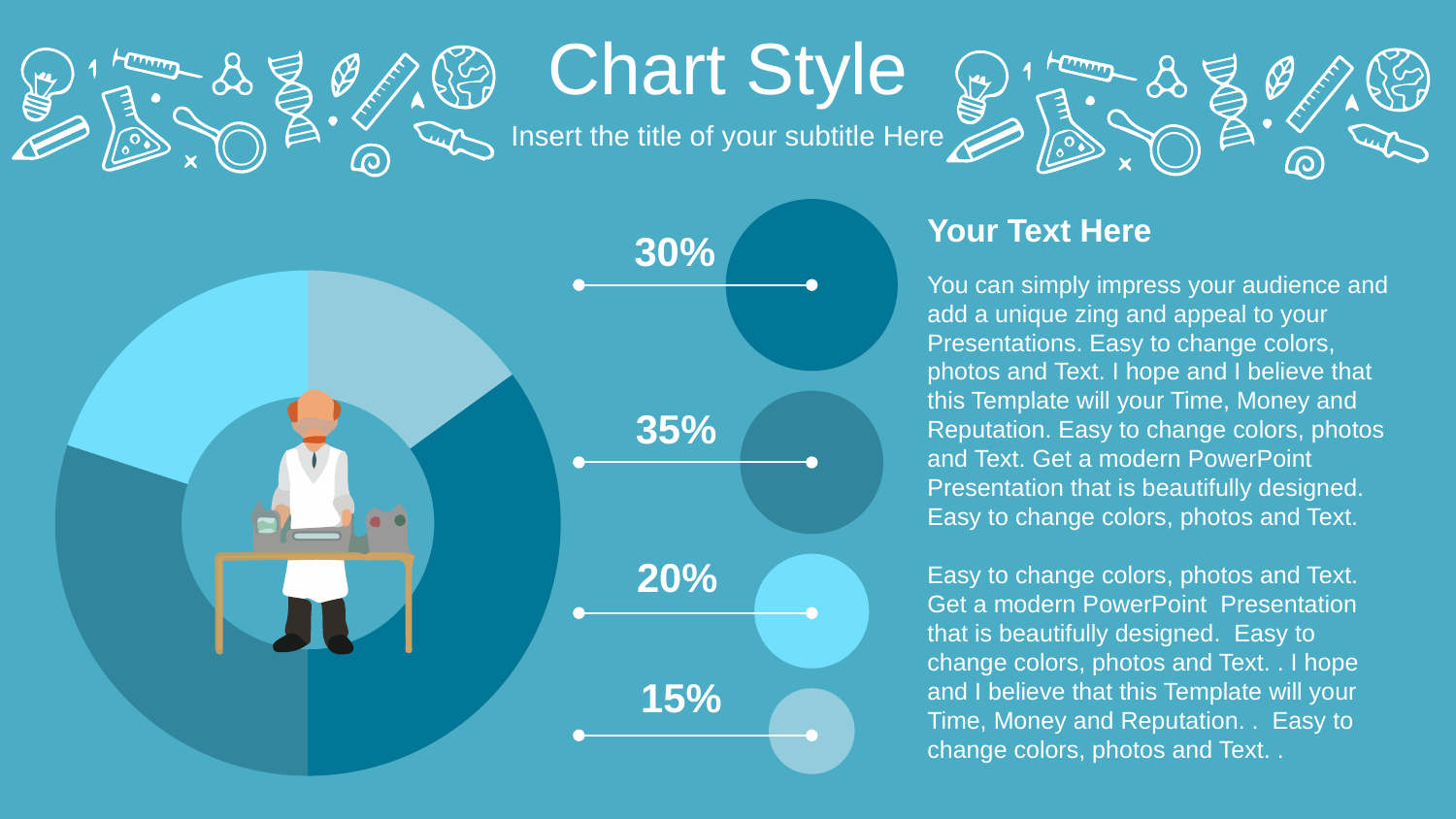
What percentage is listed third from the top next to the chart? 20% What is the subtitle text under the slide title? Insert the title of your subtitle Here What do the four percentages listed next to the chart add up to? 100% What is the largest percentage shown on the slide? 35% What is the smallest percentage shown on the slide? 15% What is the title of the slide? Chart Style What is the difference between the 35% value and the 30% value? 5% What percentage is listed at the top of the list next to the chart? 30% Which is larger, the third value (20%) or the fourth value (15%) in the list? 20% What kind of chart is shown on the left of the slide? doughnut chart How many percentage values are listed next to the chart? 4 What is the difference between the 30% value and the 15% value? 15%